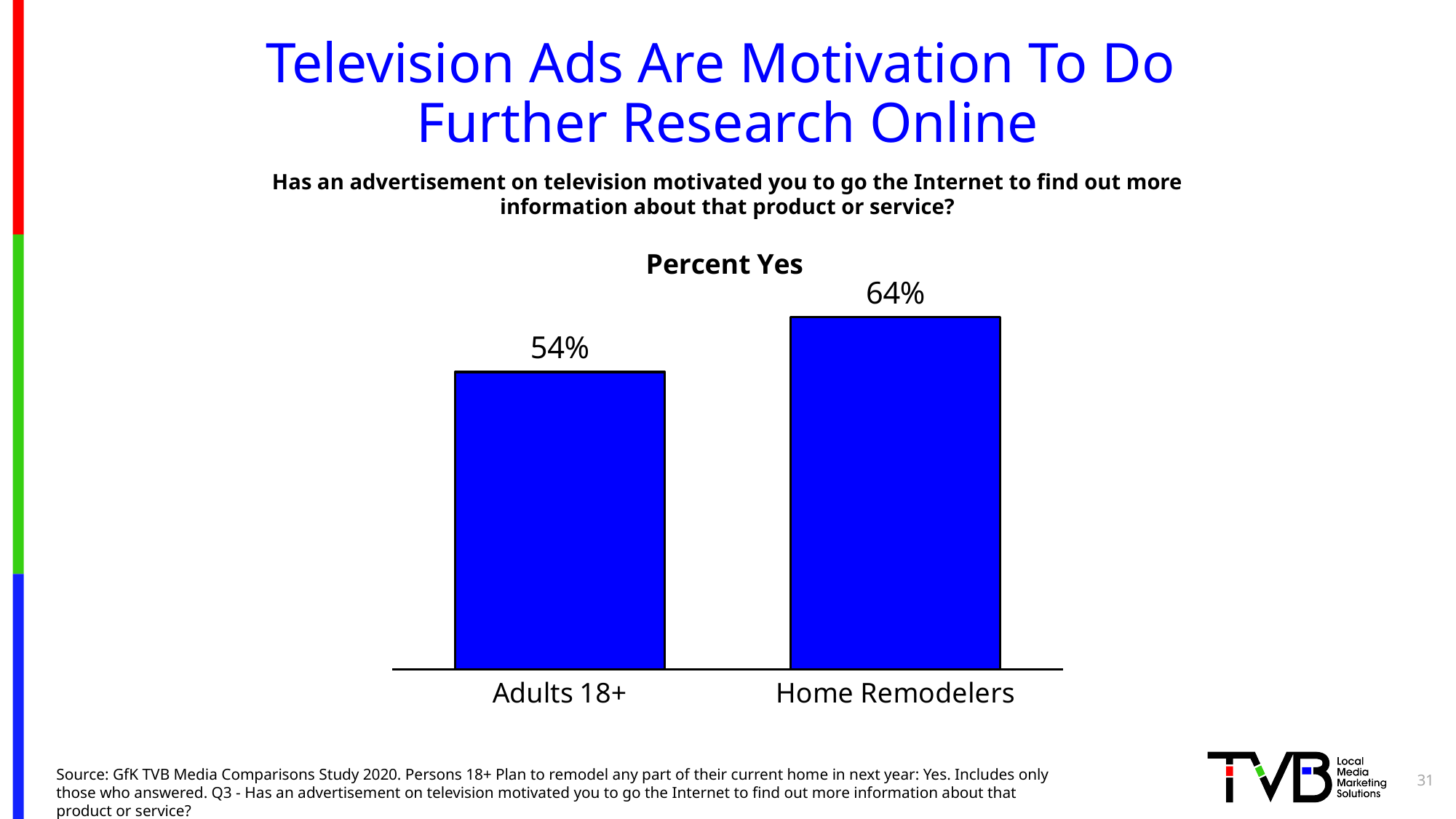
What kind of chart is shown on the slide? Bar chart What colour are the bars in the chart? Blue Which category has the highest Percent Yes value? Home Remodelers How many categories are shown in the chart? 2 What is the title of the chart? Percent Yes What is the Percent Yes value for Home Remodelers? 64% What is the difference in Percent Yes between Home Remodelers and Adults 18+? 10% Which category has the lowest Percent Yes value? Adults 18+ Which is larger, the Percent Yes for Adults 18+ or for Home Remodelers? Home Remodelers What is the Percent Yes value for Adults 18+? 54%